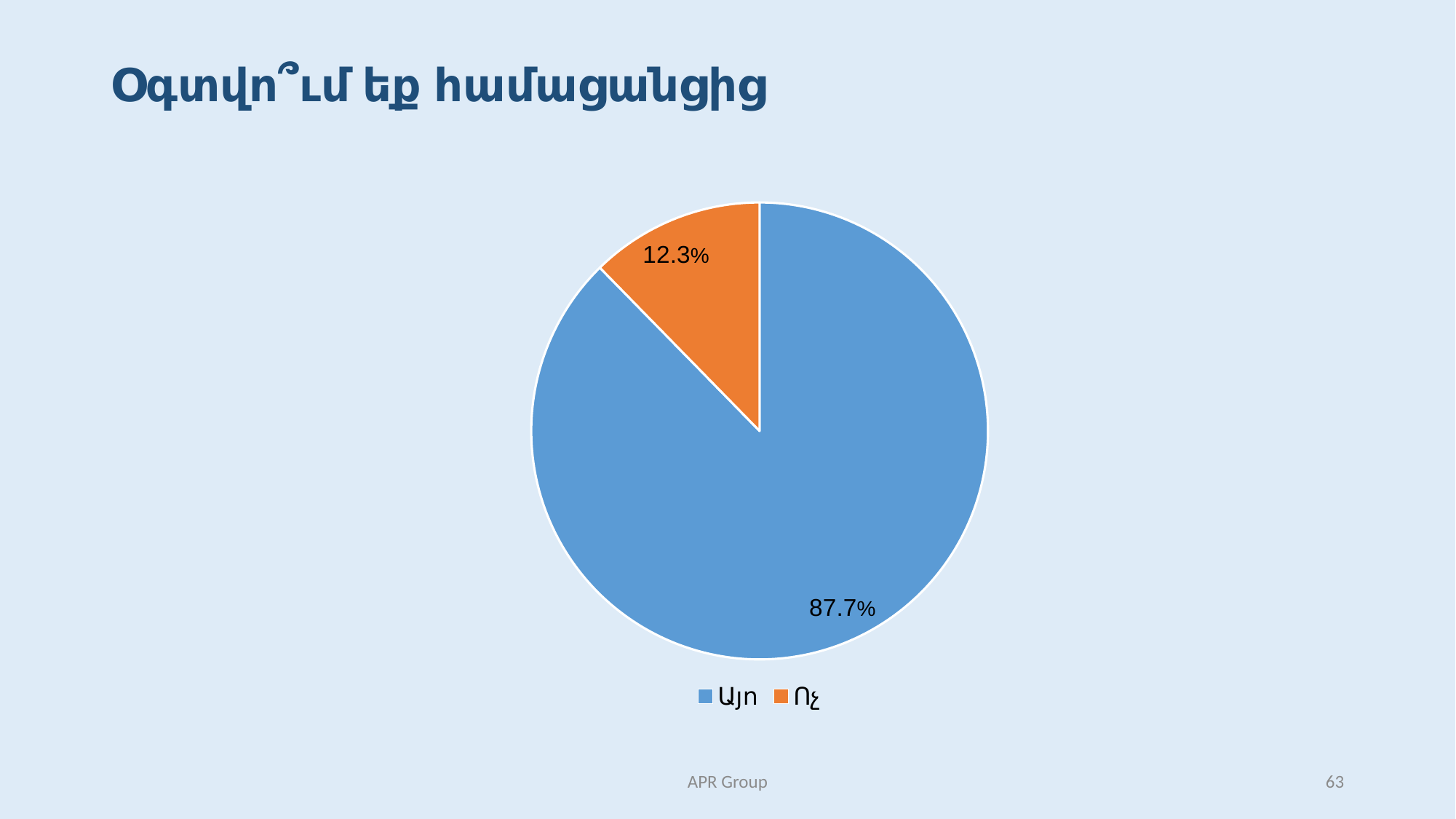
What is the value for Ոչ? 12.3% Which is larger, Այո or Ոչ? Այո What is the title of the slide above the chart? Օգտվո՞ւմ եք համացանցից How many entries does the legend list? 2 What share of the pie does the Ոչ slice represent? 12.3% How many slices does the pie chart have? 2 Which slice is the largest? Այո What kind of chart is shown on the slide? pie chart What is the value for Այո? 87.7% What colour is the Ոչ slice? orange Which slice is the smallest? Ոչ What is the difference between the Այո and Ոչ values? 75.4%